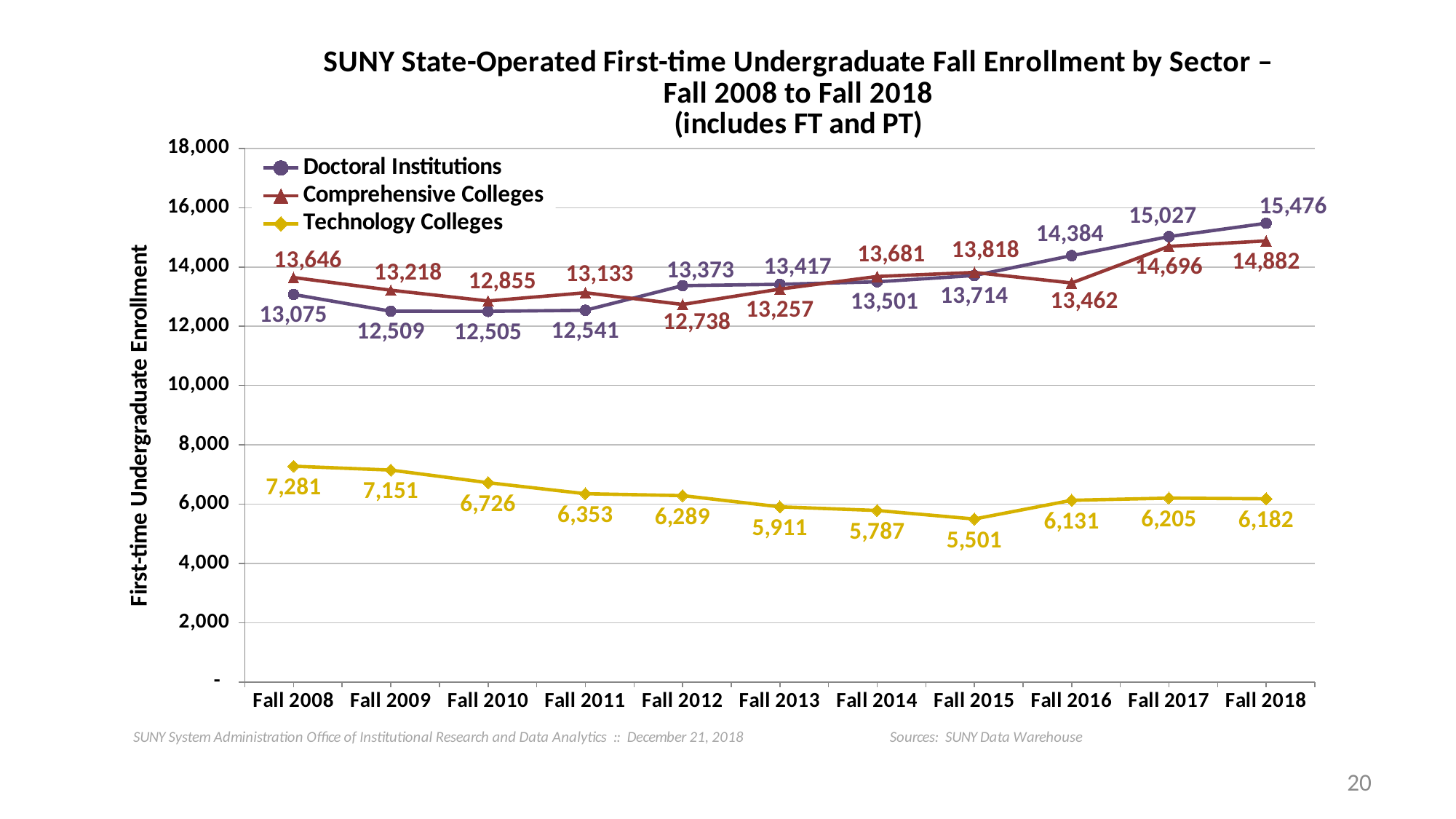
In which fall term is the Technology Colleges enrollment highest? Fall 2008 What is the difference between the Doctoral Institutions enrollment in Fall 2018 and in Fall 2008? 2,401 What is the Technology Colleges enrollment value for Fall 2015? 5,501 How many series does the legend list? 3 What is the Comprehensive Colleges enrollment value for Fall 2012? 12,738 What is the Doctoral Institutions enrollment value for Fall 2018? 15,476 Does the Technology Colleges enrollment rise or fall from Fall 2008 to Fall 2015? Fall What is the title of the y axis? First-time Undergraduate Enrollment What kind of chart is shown on the slide? Line chart How many fall terms are plotted on the x axis? 11 In which fall term is the Technology Colleges enrollment lowest? Fall 2015 In Fall 2016, which series has the larger value: Doctoral Institutions or Comprehensive Colleges? Doctoral Institutions